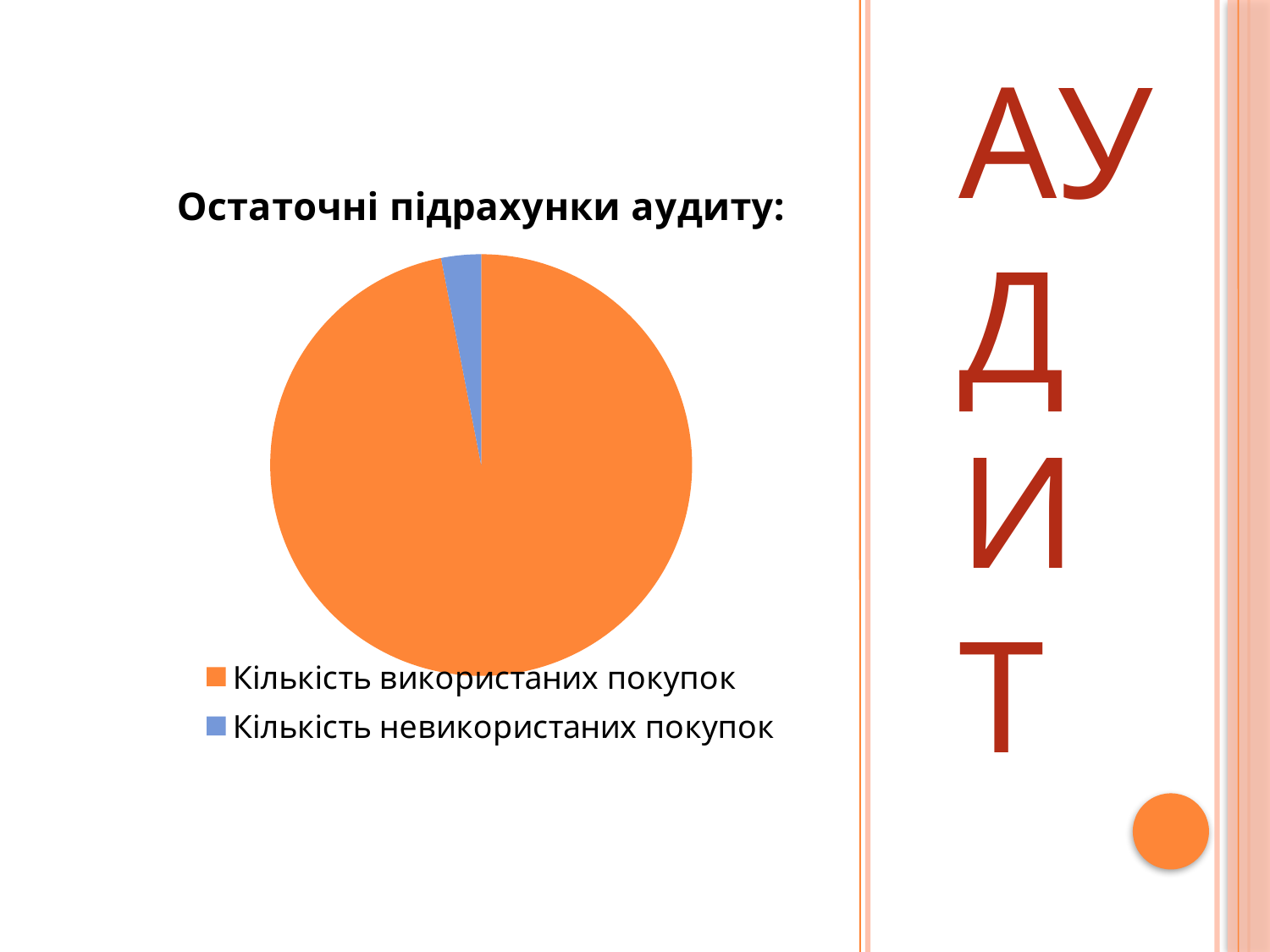
What colour is the slice for Кількість невикористаних покупок? blue Which category has the smallest slice of the pie? Кількість невикористаних покупок What is the title of the chart? Остаточні підрахунки аудиту: What kind of chart is shown on the slide? pie chart Which category has the largest slice of the pie? Кількість використаних покупок Which is larger: Кількість використаних покупок or Кількість невикористаних покупок? Кількість використаних покупок How many entries does the legend list? 2 How many slices does the pie chart have? 2